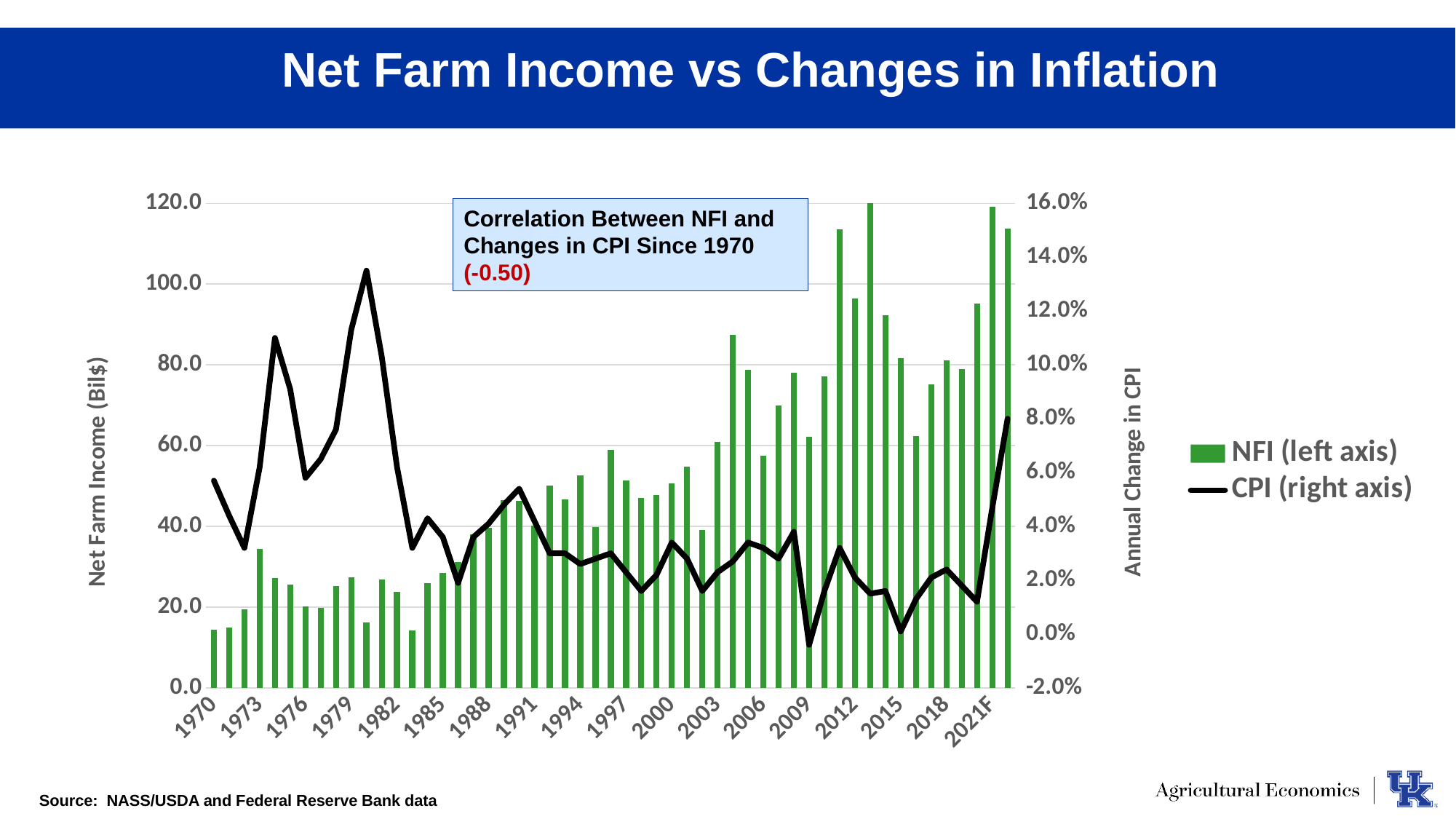
Which is larger, the Net Farm Income value for 1970 or for 2021F? 2021F Is the Net Farm Income value for 2021F greater or less than 100.0? greater What kind of chart is shown on the slide? A combination bar and line chart Which series is plotted as green bars? NFI (left axis) Overall, do the Net Farm Income bars rise or fall from 1970 to 2021F? rise Is the CPI value for 1973 greater or less than 4.0%? greater How many series does the legend list? 2 Is the CPI value for 2009 greater or less than 2.0%? less What correlation value between NFI and changes in CPI since 1970 is shown in the text box? -0.50 Which is larger, the CPI value for 1979 or for 2015? 1979